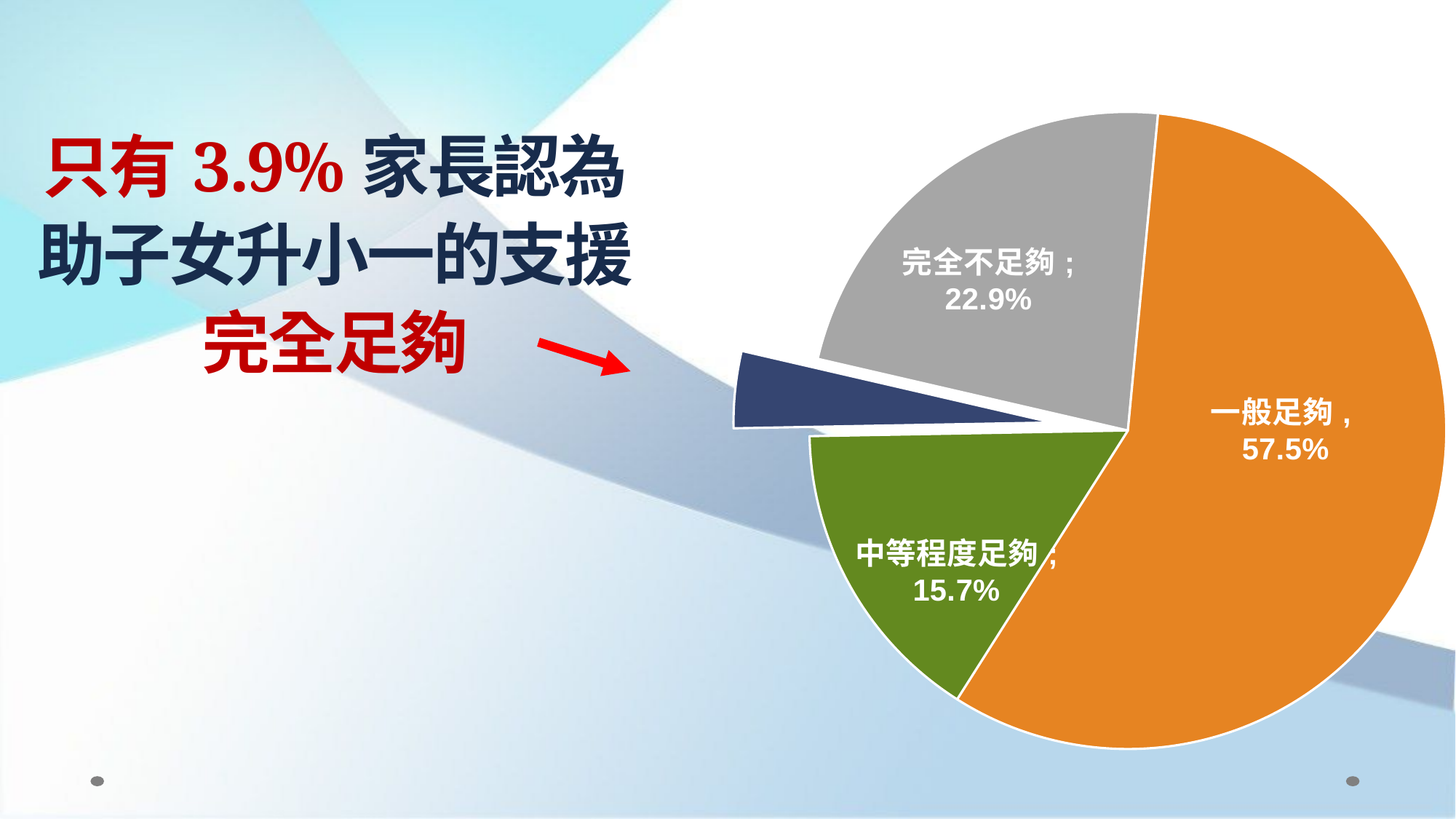
What is the difference in percentage points between the 一般足夠 slice and the 完全不足夠 slice? 34.6 What percentage of the pie is labelled 一般足夠? 57.5% Which is larger, the 完全不足夠 slice or the 中等程度足夠 slice? 完全不足夠 What percentage of the pie is labelled 完全不足夠? 22.9% How many slices does the pie chart have? 4 What is the difference in percentage points between the 完全不足夠 slice and the 中等程度足夠 slice? 7.2 According to the slide text, what percentage of parents consider the support 完全足夠? 3.9% What colour is the slice labelled 一般足夠? orange What kind of chart is shown on the slide? pie chart Which slice of the pie chart is the largest? 一般足夠 Which slice of the pie chart is the smallest? 完全足夠 What percentage of the pie is labelled 中等程度足夠? 15.7%